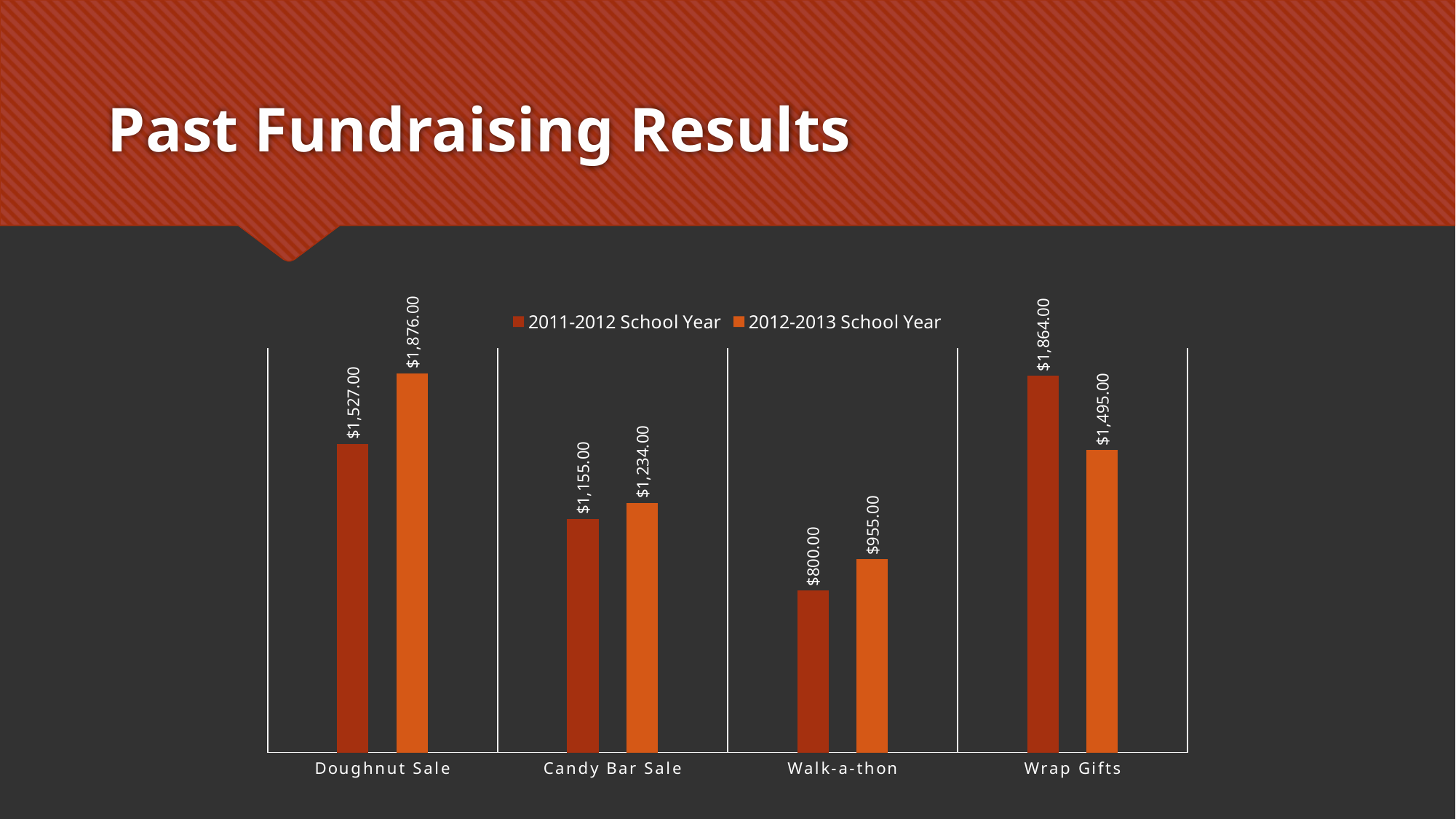
What was the Walk-a-thon result for the 2011-2012 School Year? $800.00 Which fundraiser had the lowest result in the 2012-2013 School Year? Walk-a-thon What is the difference between the 2012-2013 and 2011-2012 Candy Bar Sale results? $79.00 Which fundraiser had the highest result in the 2011-2012 School Year? Wrap Gifts What is the difference between the Doughnut Sale results for 2012-2013 and 2011-2012? $349.00 What was the Wrap Gifts result for the 2012-2013 School Year? $1,495.00 What is the title of the slide containing the chart? Past Fundraising Results What kind of chart is shown on the slide? Bar chart How many series does the legend list? 2 Which was larger for Wrap Gifts: the 2011-2012 School Year or the 2012-2013 School Year? 2011-2012 School Year What was the Doughnut Sale result for the 2012-2013 School Year? $1,876.00 How many fundraisers are shown on the x axis? 4